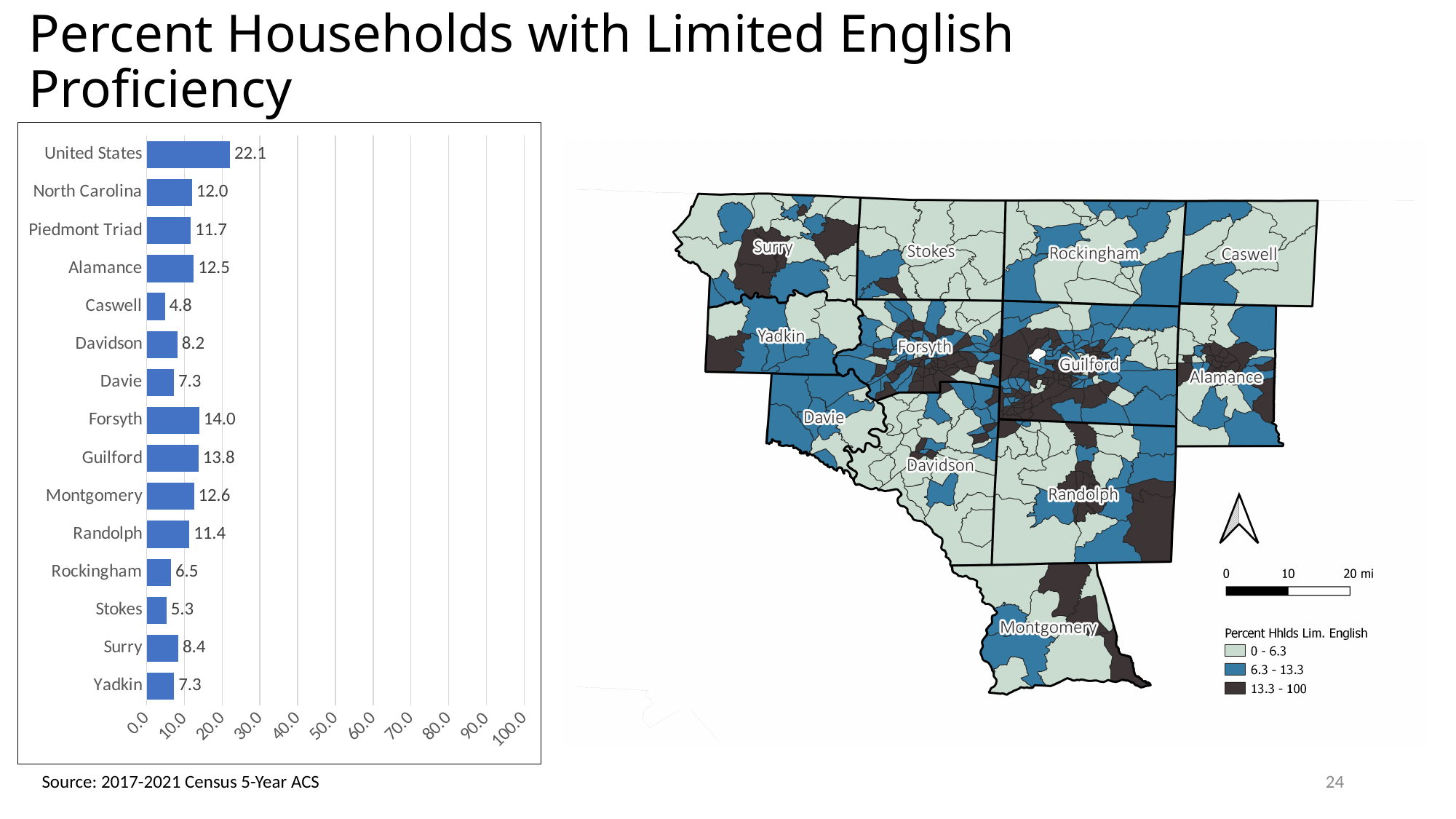
In the bar chart, what is the value for Caswell? 4.8 What kind of chart is shown on the left of the slide? bar chart In the bar chart, what is the value for the United States? 22.1 In the bar chart, which category has the highest value? United States What is the highest value shown on the x axis of the bar chart? 100.0 How many categories are shown in the bar chart? 15 In the bar chart, which category has the lowest value? Caswell In the bar chart, what is the value for Piedmont Triad? 11.7 In the bar chart, which is larger, the value for Alamance or the value for Rockingham? Alamance In the bar chart, what is the difference between the United States value and the North Carolina value? 10.1 In the bar chart, is the value for Stokes greater or less than 10.0? less In the bar chart, what is the value for Forsyth? 14.0